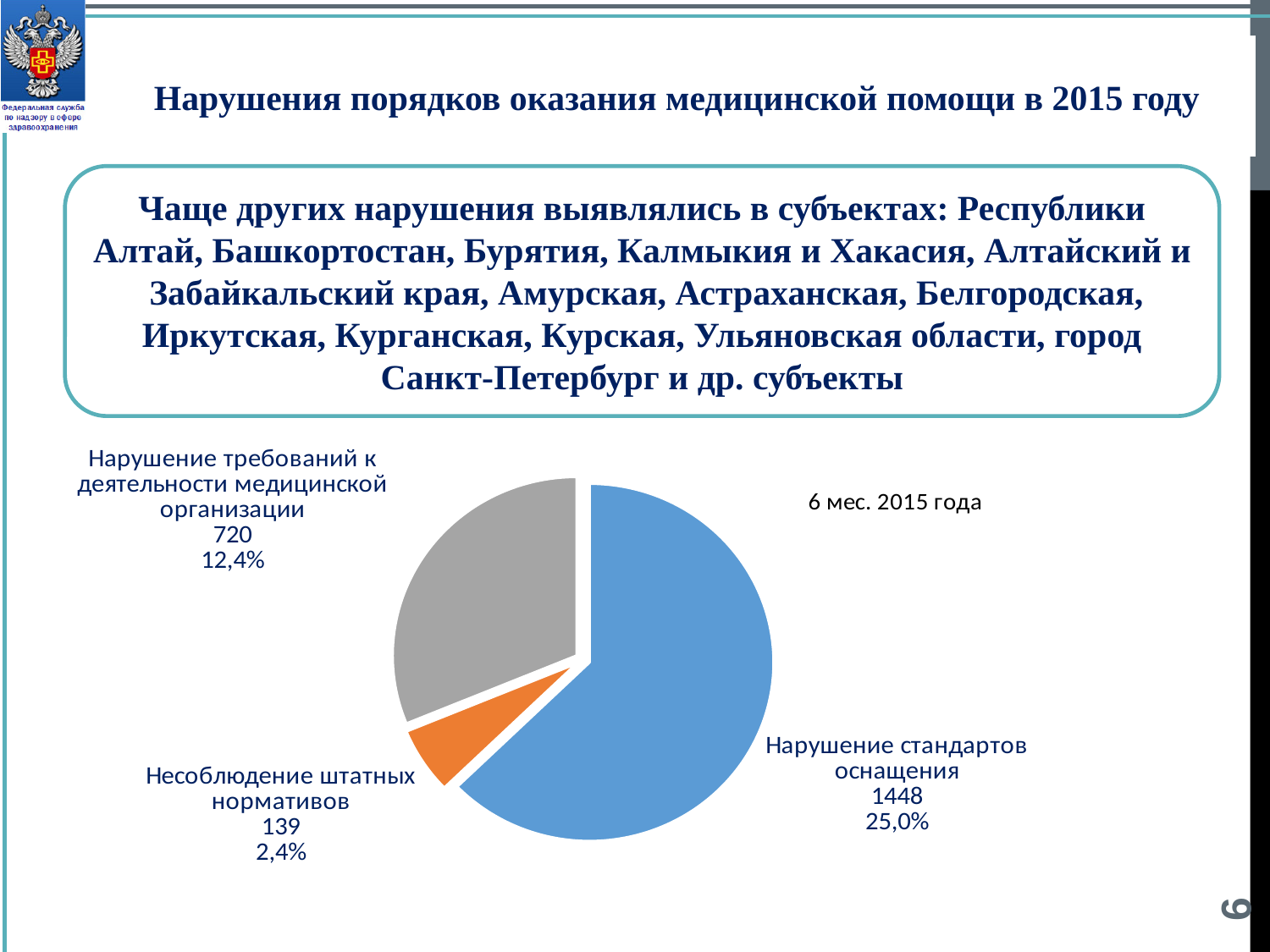
Which category has the largest slice in the pie chart? Нарушение стандартов оснащения Which is larger: the value for "Нарушение требований к деятельности медицинской организации" or for "Несоблюдение штатных нормативов"? Нарушение требований к деятельности медицинской организации What is the value shown for "Нарушение требований к деятельности медицинской организации"? 720 What is the value shown for "Нарушение стандартов оснащения"? 1448 What kind of chart is shown on the slide? pie chart What percentage is printed for "Несоблюдение штатных нормативов"? 2,4% How many slices does the pie chart have? 3 What is the difference between the values for "Нарушение стандартов оснащения" and "Нарушение требований к деятельности медицинской организации"? 728 Which category has the smallest slice in the pie chart? Несоблюдение штатных нормативов What percentage is printed for "Нарушение стандартов оснащения"? 25,0% What is the value shown for "Несоблюдение штатных нормативов"? 139 What is the title of the pie chart? 6 мес. 2015 года